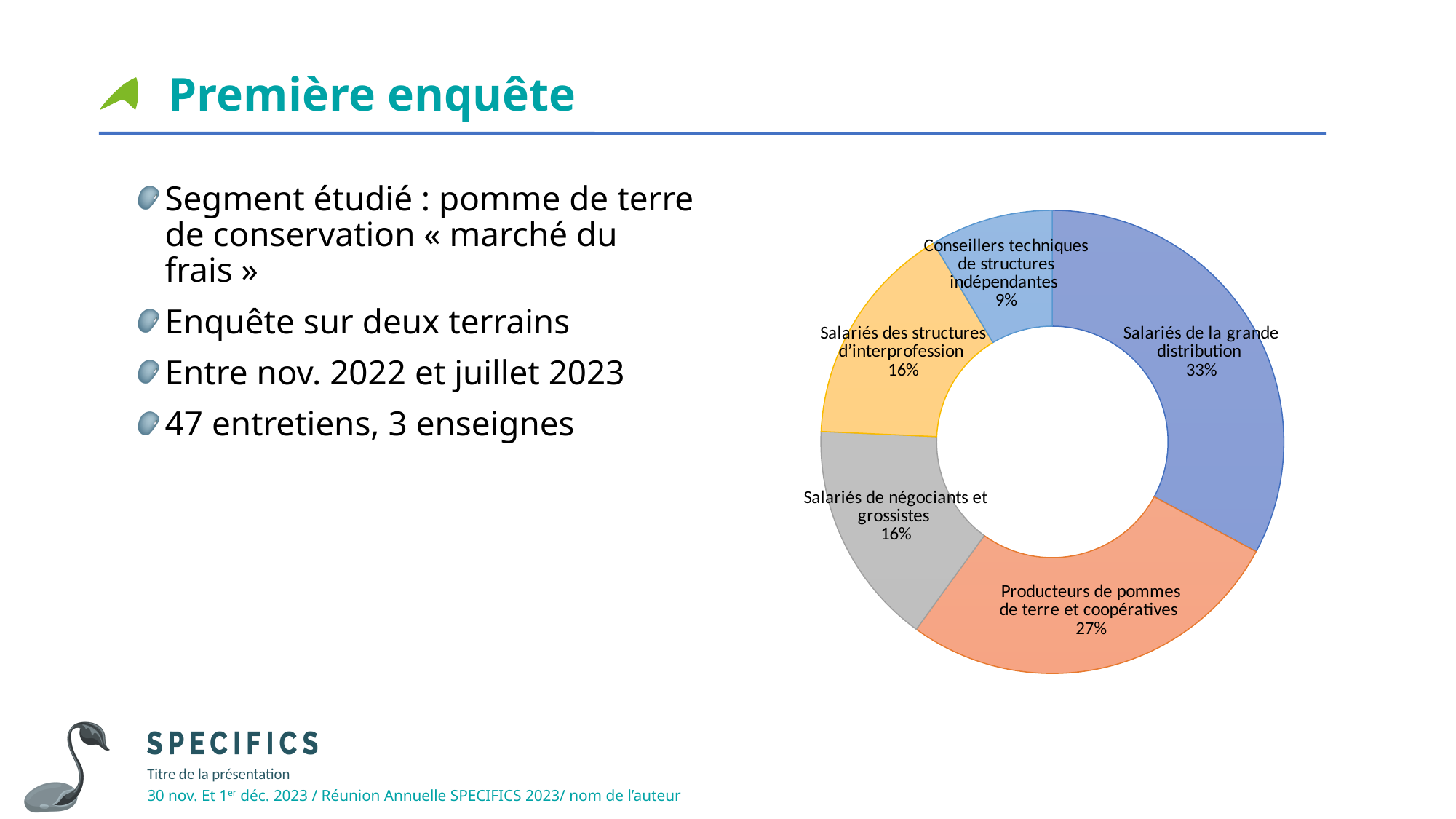
Which is larger: the share for 'Producteurs de pommes de terre et coopératives' or the share for 'Salariés des structures d'interprofession'? Producteurs de pommes de terre et coopératives What colour is the slice for 'Producteurs de pommes de terre et coopératives'? Orange Which category has the largest share of the chart? Salariés de la grande distribution What share of the chart is 'Salariés de négociants et grossistes'? 16% What is the difference in percentage points between 'Salariés de la grande distribution' and 'Producteurs de pommes de terre et coopératives'? 6 percentage points How many categories does the chart show? 5 What share of the chart is 'Conseillers techniques de structures indépendantes'? 9% Which two categories have the same share of the chart? Salariés des structures d'interprofession and Salariés de négociants et grossistes Which category has the smallest share of the chart? Conseillers techniques de structures indépendantes What share of the chart is 'Salariés de la grande distribution'? 33% What share of the chart is 'Producteurs de pommes de terre et coopératives'? 27% What kind of chart is shown on the slide? Doughnut (pie) chart